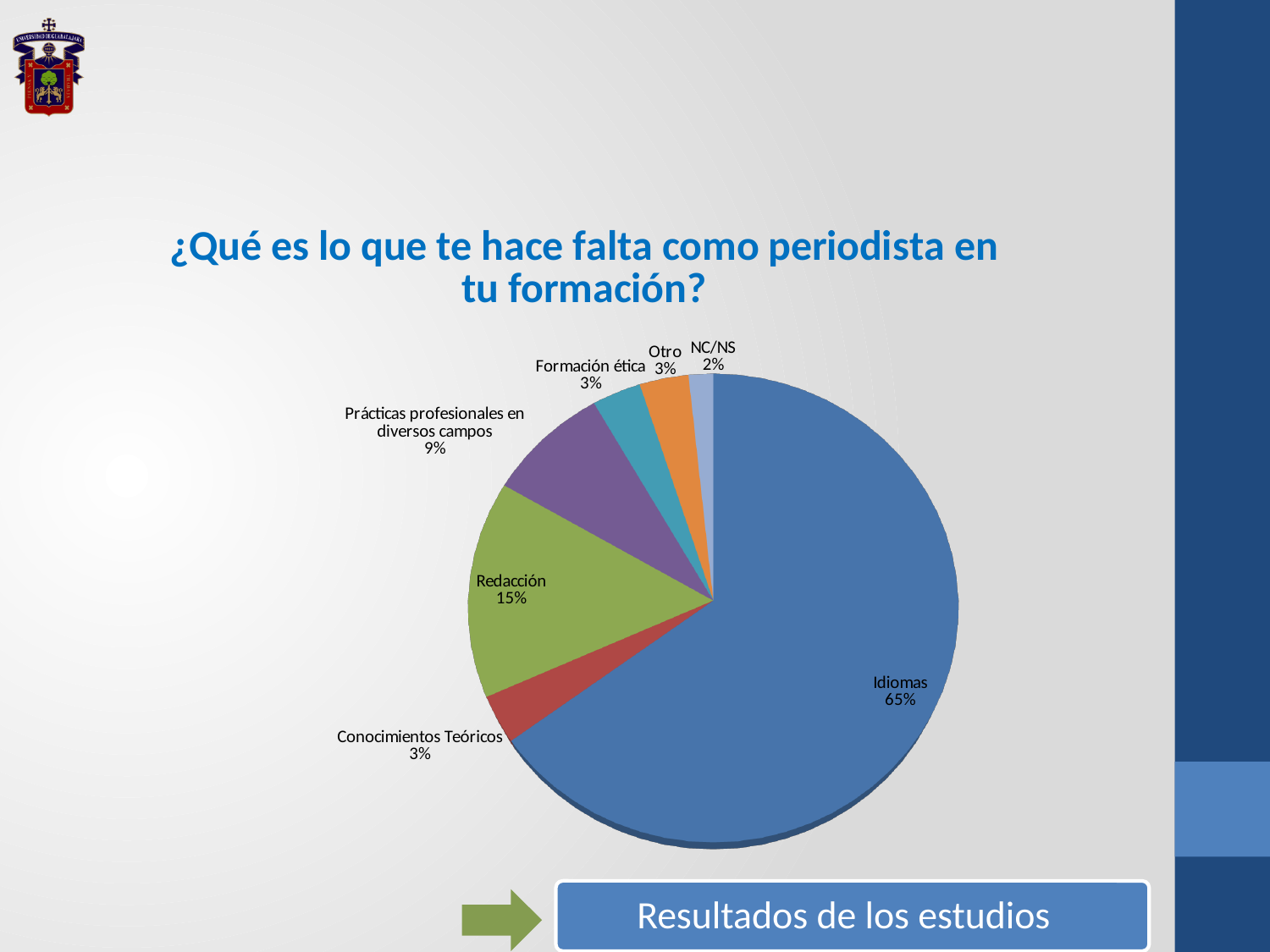
What is the title of the chart? ¿Qué es lo que te hace falta como periodista en tu formación? Which category has the largest slice of the pie? Idiomas What is the difference between the shares for Idiomas and Redacción? 50% What share of the pie does Prácticas profesionales en diversos campos have? 9% Which is larger, the share for Redacción or the share for Prácticas profesionales en diversos campos? Redacción What kind of chart is shown on the slide? pie chart What share of the pie does NC/NS have? 2% What share of the pie does Redacción have? 15% What is the value shown for Conocimientos Teóricos? 3% How many slices does the pie chart have? 7 Which category has the smallest slice of the pie? NC/NS